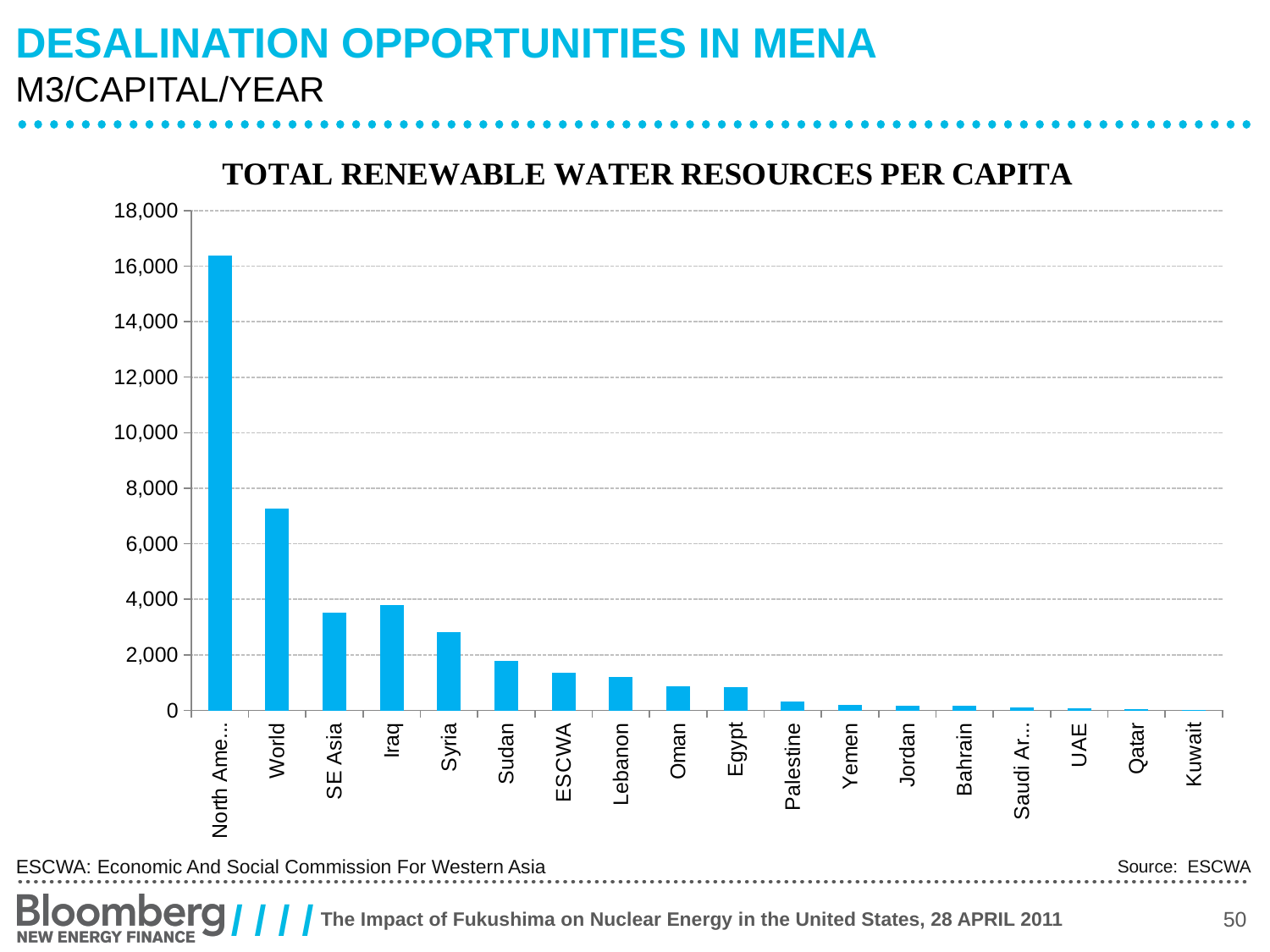
How many categories are plotted on the x axis of the chart? 18 Which category has the highest value in the chart? North Ame... Which has a larger value, World or Syria? World Is the value for World greater or less than 6,000? greater Do the values generally rise or fall moving from left to right along the x axis? fall Is the value for Iraq greater or less than 4,000? less What is the title of the chart? TOTAL RENEWABLE WATER RESOURCES PER CAPITA What kind of chart is shown on the slide? bar chart Is the value for Sudan greater or less than 2,000? less Which has a larger value, Lebanon or Palestine? Lebanon